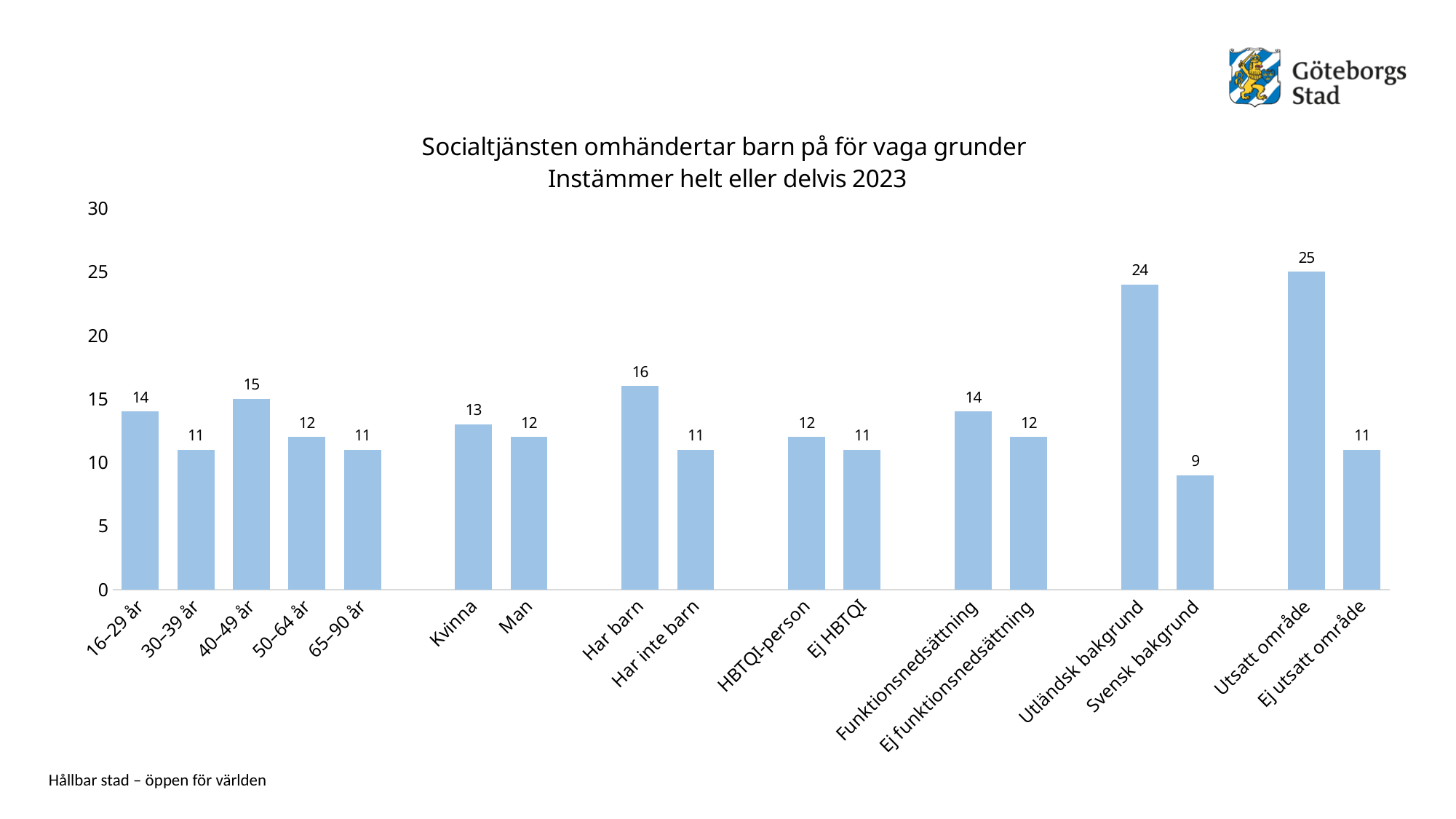
What is the value for Kvinna? 13 Is the value for Utländsk bakgrund greater or less than 20? greater What kind of chart is shown on the slide? Bar chart Which category has the highest value? Utsatt område Which is larger, the value for Har barn or the value for Har inte barn? Har barn What is the value for 40–49 år? 15 What is the value for Har barn? 16 What is the difference between the values for Utländsk bakgrund and Svensk bakgrund? 15 Which category has the lowest value? Svensk bakgrund What is the value for Utländsk bakgrund? 24 How many categories are shown on the x axis? 17 What is the difference between the values for Utsatt område and Ej utsatt område? 14